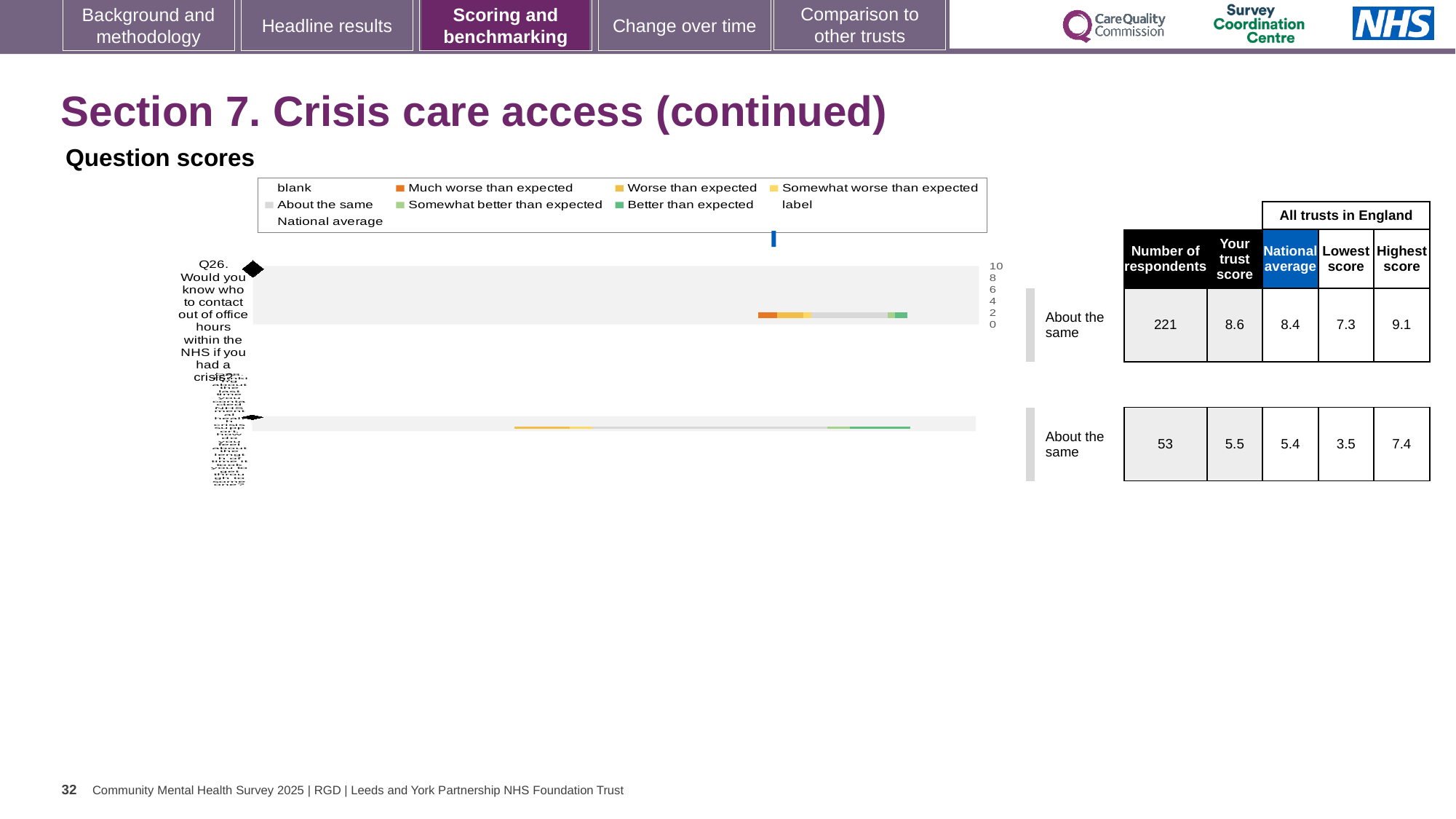
What benchmark category is shown for Q26 in the question scores chart? About the same For Q26, what is the difference between the highest and lowest scores among all trusts in England? 1.8 In the question scores chart, what is the number of respondents for Q26 (Would you know who to contact out of office hours within the NHS if you had a crisis?)? 221 In the question scores chart, what is the highest score among all trusts in England for Q26? 9.1 What kind of chart is used to show the question scores on this slide? bar chart For Q26, how much higher is the trust's score than the national average? 0.2 How many question rows are plotted in the question scores chart? 2 In the question scores chart, what is the trust's score for Q26? 8.6 In the question scores chart, what is the national average for Q26? 8.4 In the question scores chart, what is the trust's score for the second question row? 5.5 In the question scores chart, what is the lowest score among all trusts in England for Q26? 7.3 For Q26, which is larger: the trust's score or the national average? the trust's score